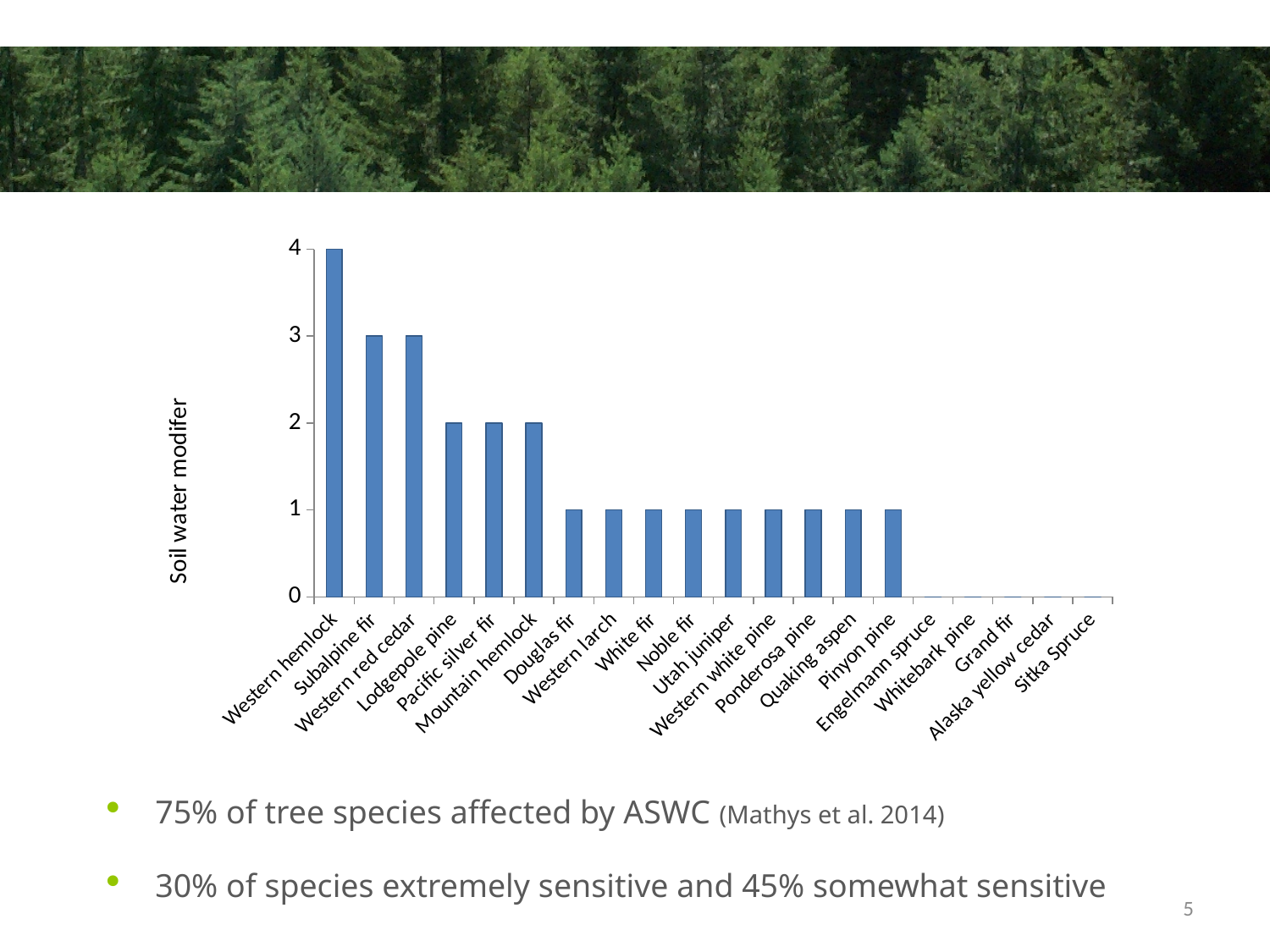
What is the soil water modifier value for Western hemlock? 4 Which has a larger soil water modifier, Subalpine fir or Douglas fir? Subalpine fir Which tree species has the highest soil water modifier? Western hemlock Do the values rise or fall moving from left to right along the x axis? fall What is the soil water modifier value for Grand fir? 0 How many tree species are shown on the x axis of the chart? 20 What is the soil water modifier value for Subalpine fir? 3 What is the soil water modifier value for Lodgepole pine? 2 What is the difference between the soil water modifier for Western hemlock and for Lodgepole pine? 2 What is the label on the y axis of the chart? Soil water modifer What is the soil water modifier value for Douglas fir? 1 What kind of chart is shown on the slide? bar chart